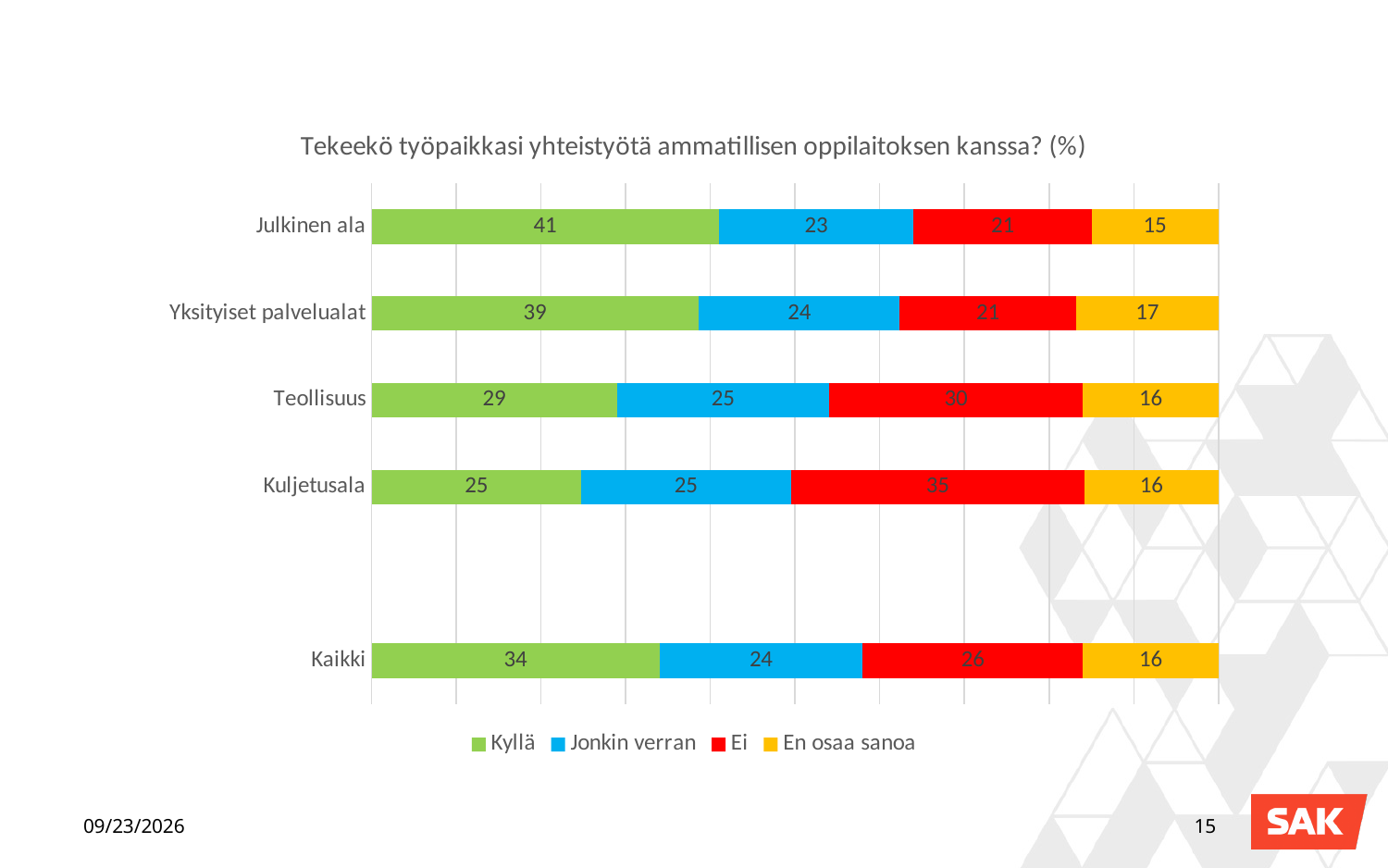
How many series does the legend list? 4 What is the En osaa sanoa value for Yksityiset palvelualat? 17 Which category has the lowest Ei value? Julkinen ala and Yksityiset palvelualat (both 21) What is the Ei value for Kuljetusala? 35 Which category has the highest Kyllä value? Julkinen ala Which is larger, the Kyllä value for Teollisuus or the Kyllä value for Kuljetusala? Teollisuus How many categories are shown on the y axis? 5 What is the Kyllä value for Julkinen ala? 41 What is the Jonkin verran value for Kaikki? 24 What is the difference between the Ei values for Kuljetusala and Teollisuus? 5 What kind of chart is shown on the slide? Stacked bar chart What is the total of the stacked bar for Kaikki? 100